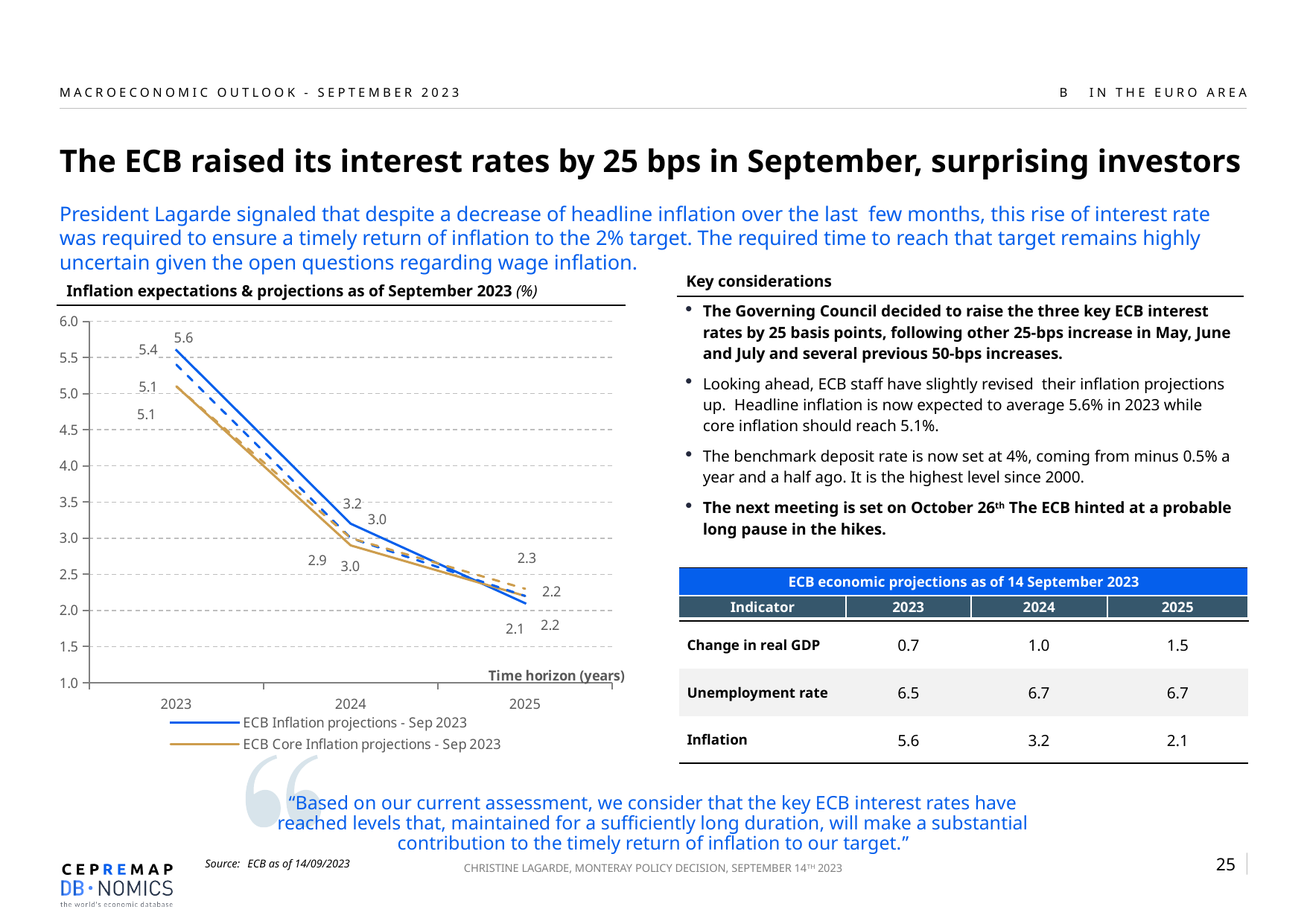
Which is higher for 2023: the ECB inflation projection or the ECB core inflation projection? ECB inflation projection What is the label of the x axis of the chart? Time horizon (years) What is the ECB inflation projection for 2023 in the chart? 5.6 How many series does the chart legend list? 2 What is the ECB inflation projection for 2024 in the chart? 3.2 What is the ECB inflation projection for 2025 in the chart? 2.1 What kind of chart is shown on the slide? Line chart Do the ECB inflation projections rise or fall from 2023 to 2025? Fall What is the ECB core inflation projection for 2023 in the chart? 5.1 How many years are shown on the x axis of the chart? 3 Is the ECB core inflation projection for 2024 greater or less than 3.5? less What is the difference between the ECB inflation projections for 2023 and 2024? 2.4